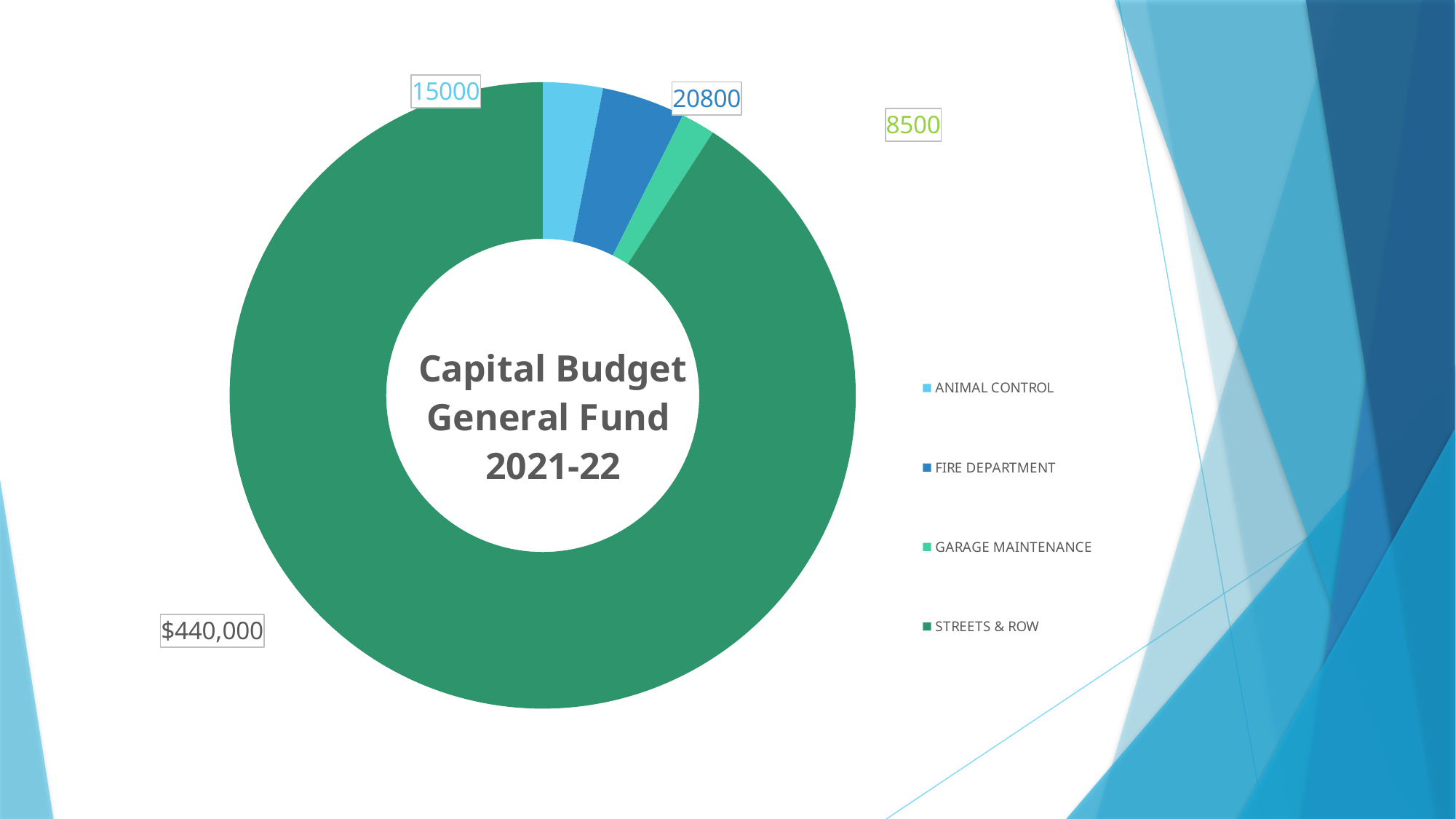
What is the value shown for Animal Control? 15000 Which category has the smallest value? Garage Maintenance What is the difference between the Fire Department value and the Animal Control value? 5800 What is the value shown for Streets & ROW? $440,000 What is the value shown for Garage Maintenance? 8500 How many categories are shown in the chart? 4 Which category has the largest share of the chart? Streets & ROW What kind of chart is shown on the slide? Pie chart (doughnut) What is the value shown for Fire Department? 20800 Which is larger, the value for Fire Department or the value for Animal Control? Fire Department What is the difference between the Animal Control value and the Garage Maintenance value? 6500 What is the title shown in the centre of the chart? Capital Budget General Fund 2021-22